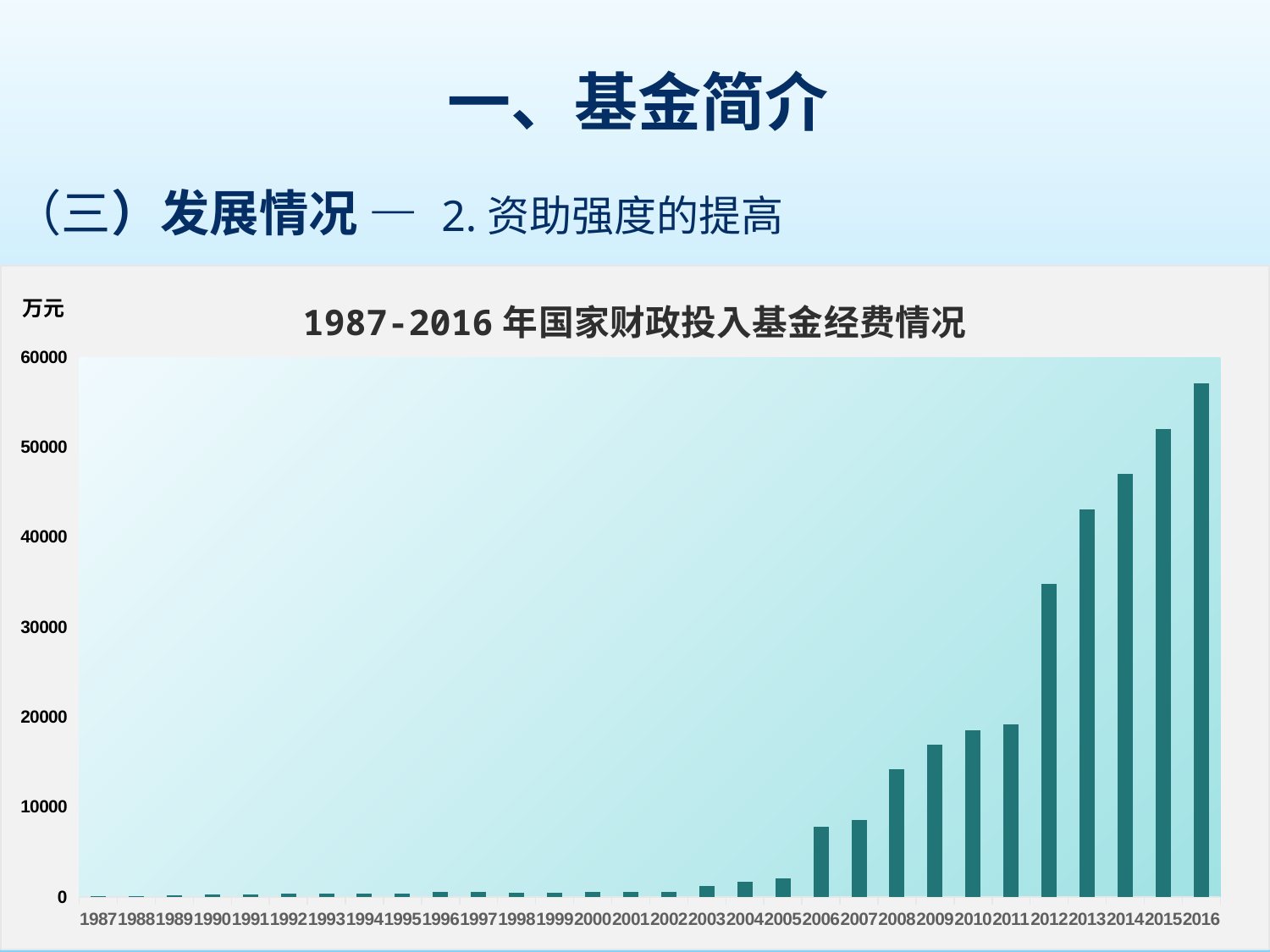
Is the value for 2014 greater or less than 50000? less Which year has the larger value, 2008 or 2007? 2008 What is the title of the chart? 1987-2016 年国家财政投入基金经费情况 Is the value for 2010 greater or less than 20000? less Is the value for 2006 greater or less than 10000? less What kind of chart is shown on the slide? bar chart How many years are plotted along the x axis of the chart? 30 Do the values generally rise or fall from 1987 to 2016? rise Which year has the highest value in the chart? 2016